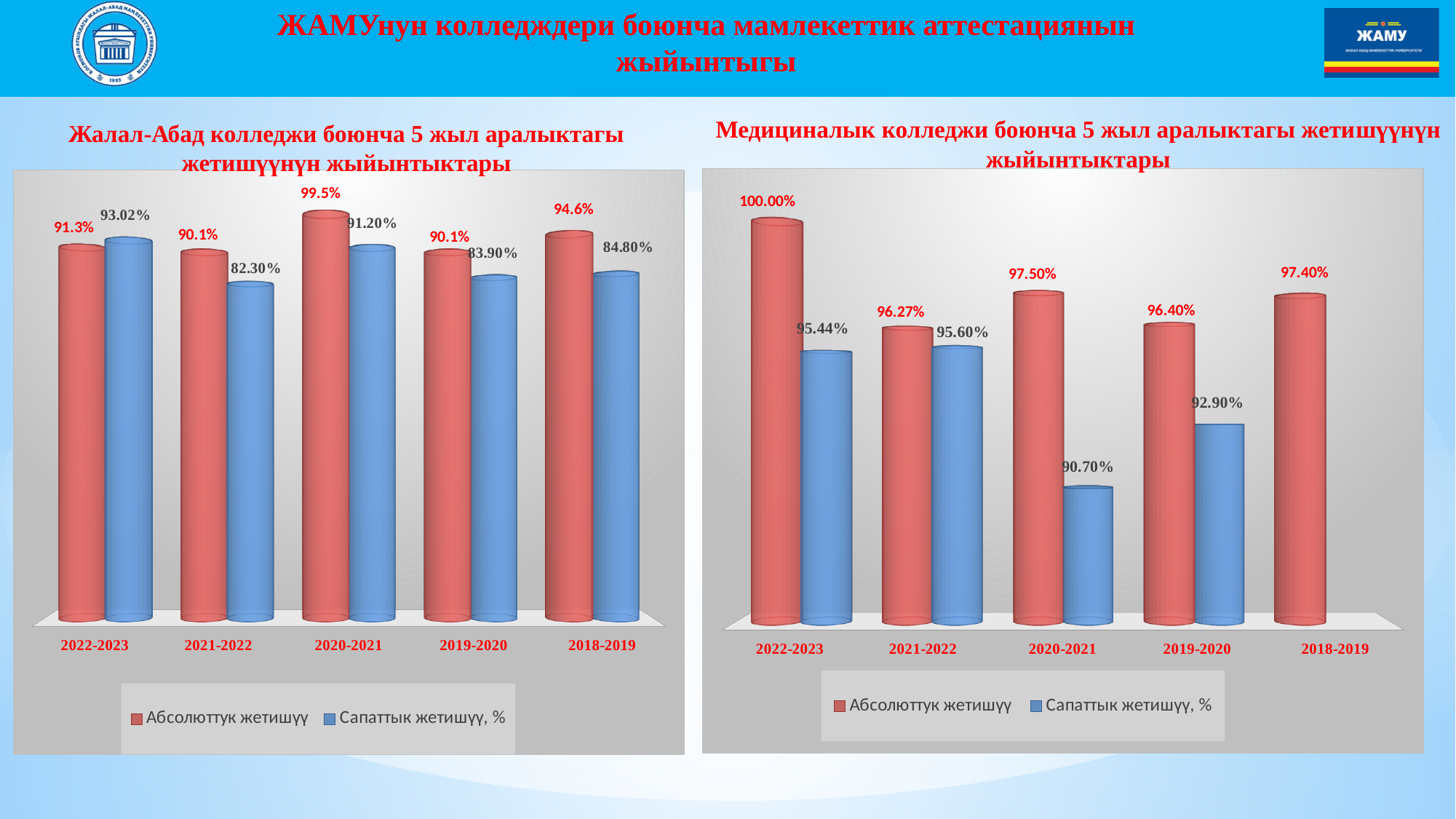
In the right chart (Медициналык колледжи), what is the value of Сапаттык жетишүү for 2020-2021? 90.70% How many year categories are shown on the x axis of the left chart (Жалал-Абад колледжи)? 5 In the right chart (Медициналык колледжи), what is the value of Абсолюттук жетишүү for 2022-2023? 100.00% In the left chart (Жалал-Абад колледжи), what is the value of Сапаттык жетишүү for 2021-2022? 82.30% In the left chart (Жалал-Абад колледжи), which is larger for 2022-2023: Абсолюттук жетишүү or Сапаттык жетишүү? Сапаттык жетишүү In the left chart (Жалал-Абад колледжи), which year has the lowest Сапаттык жетишүү? 2021-2022 How many series does the legend of the right chart (Медициналык колледжи) list? 2 In the right chart (Медициналык колледжи), which year has the lowest Сапаттык жетишүү? 2020-2021 What type of chart is the left chart (Жалал-Абад колледжи)? Bar chart In the left chart (Жалал-Абад колледжи), what is the value of Абсолюттук жетишүү for 2020-2021? 99.5% In the right chart (Медициналык колледжи), what is the difference between Абсолюттук жетишүү and Сапаттык жетишүү for 2022-2023? 4.56% In the left chart (Жалал-Абад колледжи), which year has the highest Абсолюттук жетишүү? 2020-2021